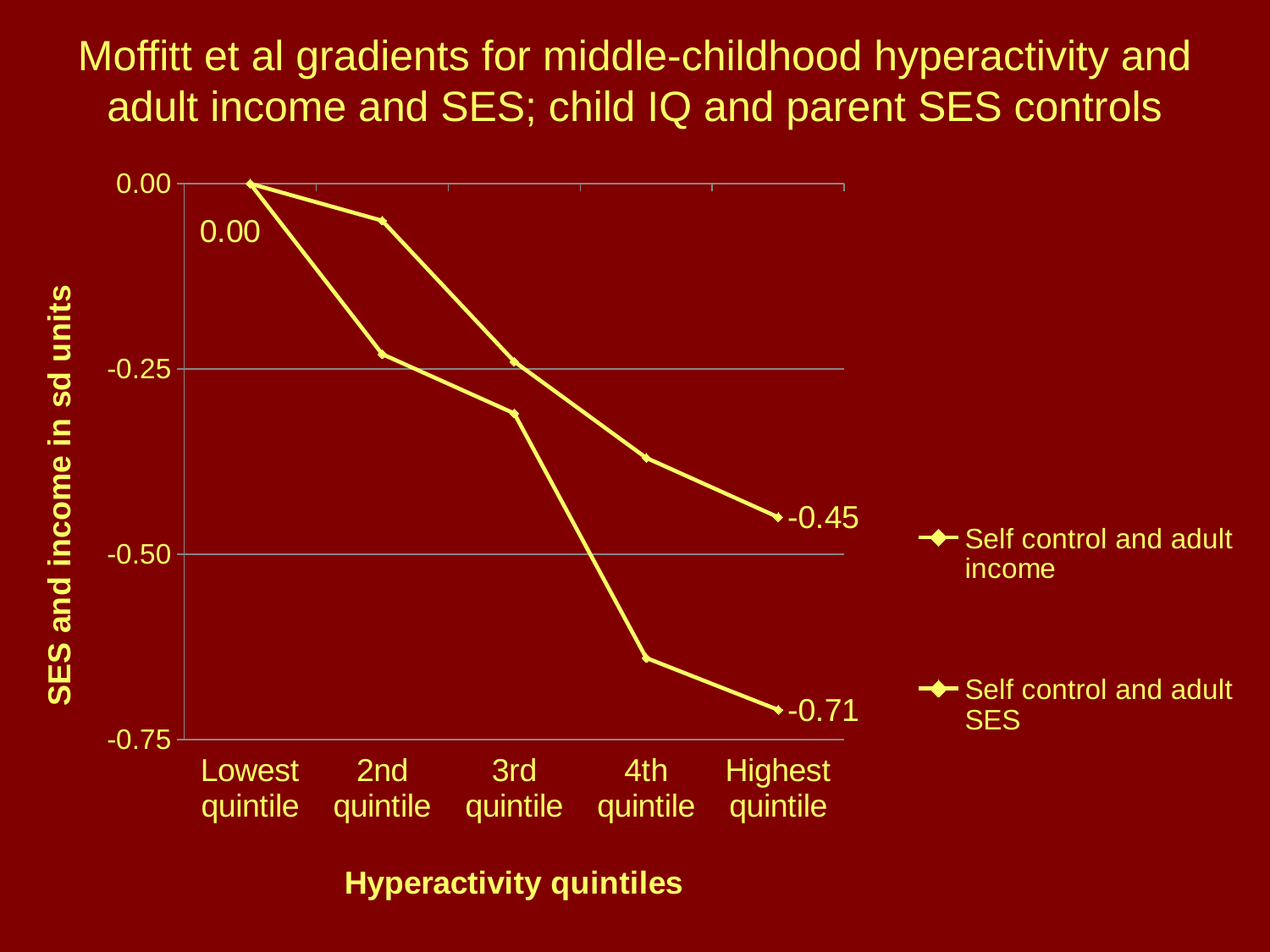
Is the value of the upper line at the 2nd quintile greater or less than -0.25? greater What is the labelled value at the Highest quintile for the line that ends lowest on the chart? -0.71 Which quintile has the lowest plotted values on the chart? Highest quintile How many series does the legend list? 2 What is the difference between the two labelled values at the Highest quintile, -0.45 and -0.71? 0.26 What is the title of the x axis? Hyperactivity quintiles What value is labelled at the Lowest quintile, where both lines start? 0.00 Do the plotted values rise or fall as hyperactivity moves from the Lowest quintile to the Highest quintile? fall Is the value of the lower line at the 4th quintile greater or less than -0.50? less What kind of chart is shown on the slide? line chart What is the labelled value at the Highest quintile for the line that ends higher on the chart? -0.45 How many hyperactivity quintiles are plotted along the x axis? 5